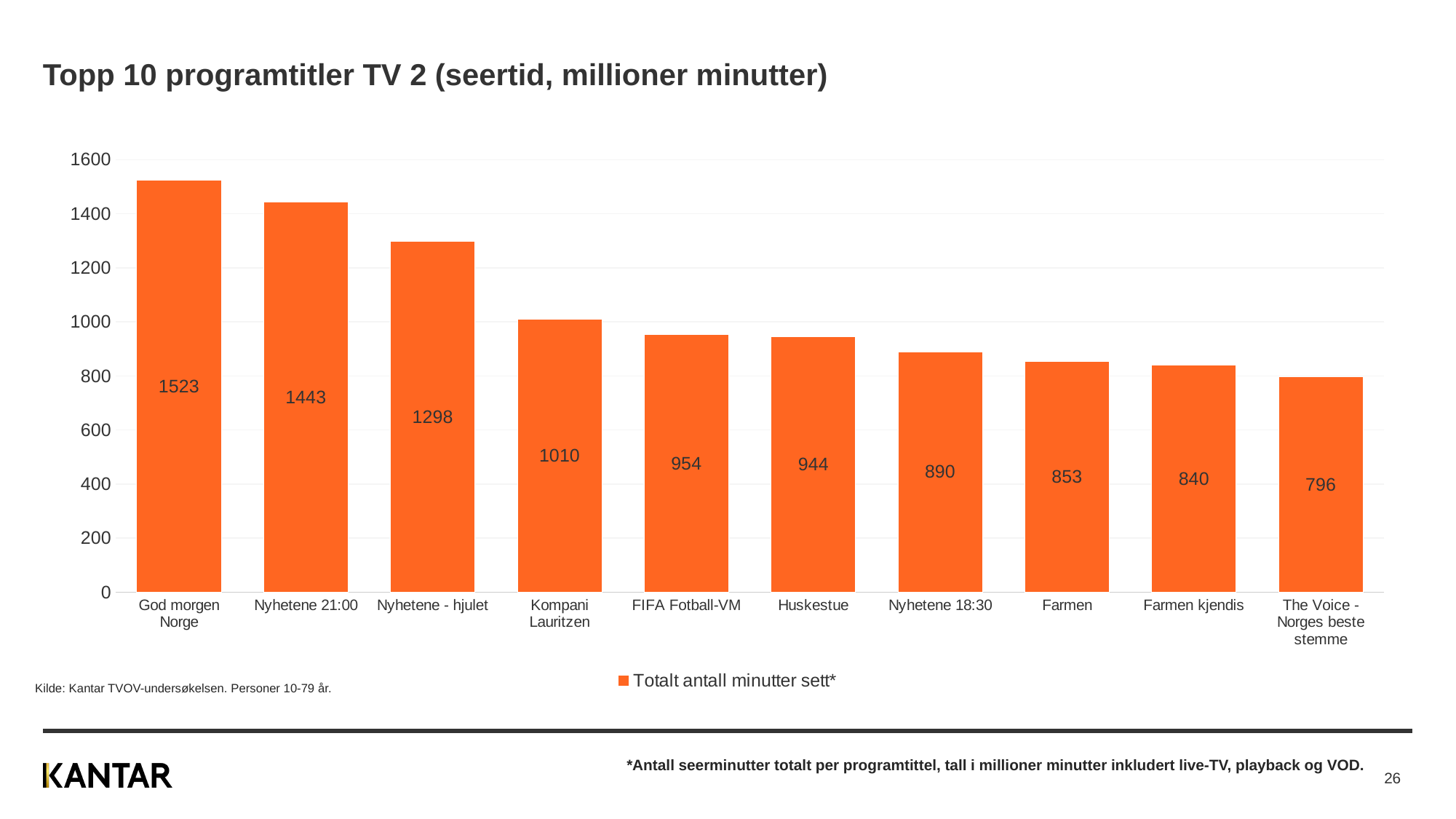
What is the value for God morgen Norge? 1523 What is the value for Kompani Lauritzen? 1010 Which program title has the lowest value? The Voice - Norges beste stemme Which has a larger value, Huskestue or Nyhetene 18:30? Huskestue How many program titles are shown on the chart? 10 What is the value for Farmen kjendis? 840 Which program title has the highest value? God morgen Norge Is the value for FIFA Fotball-VM greater or less than 1000? less Do the values rise or fall from left to right along the x axis? fall What kind of chart is shown on the slide? bar chart How many series does the legend list? 1 What is the difference between the values for Nyhetene 21:00 and Nyhetene - hjulet? 145